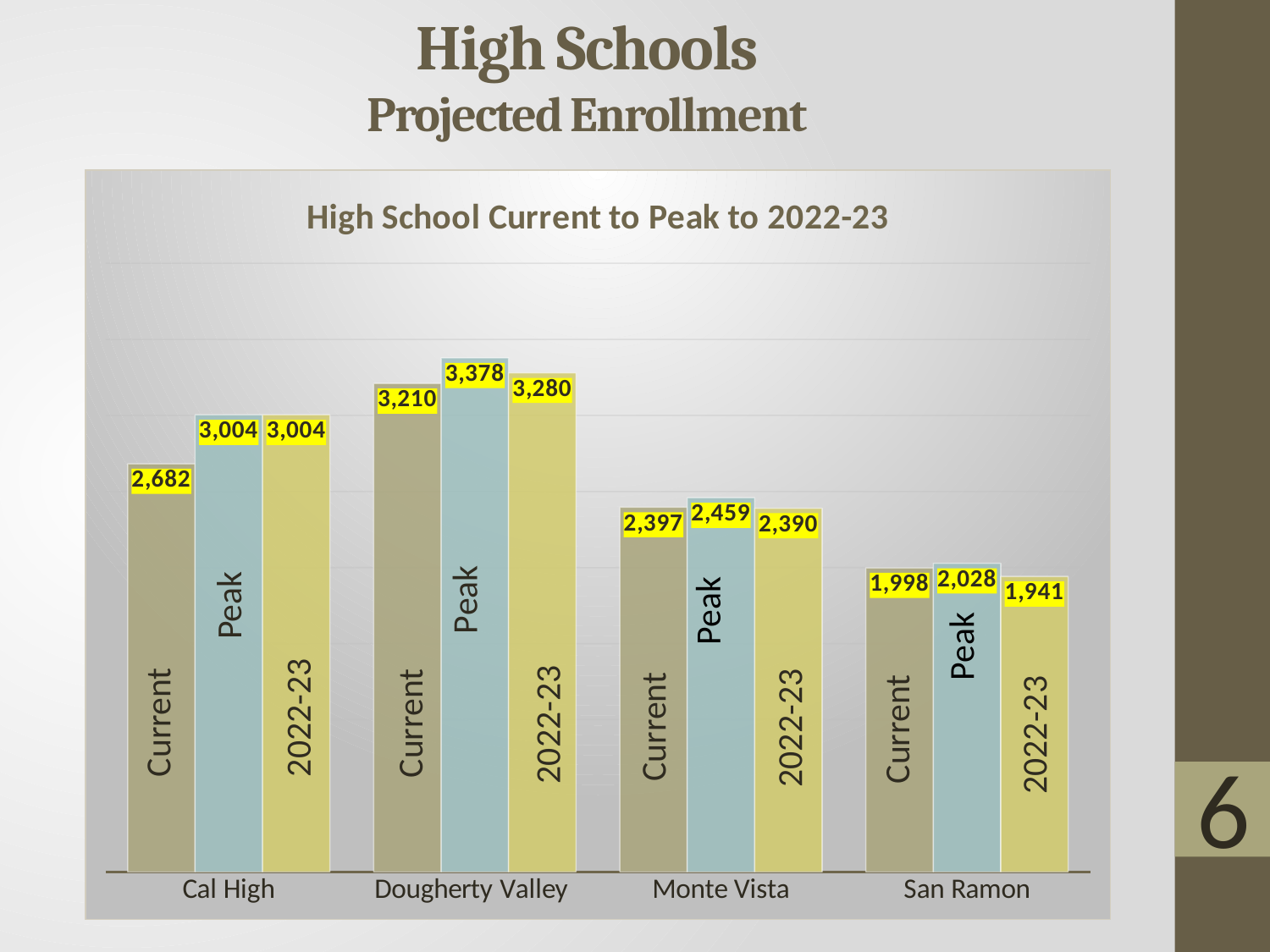
What is the 2022-23 projected enrollment for Monte Vista? 2,390 What is the Current enrollment for Cal High? 2,682 How many schools are shown on the x axis? 4 Which is larger for Monte Vista, the Current enrollment or the 2022-23 enrollment? Current What is the Peak enrollment for Dougherty Valley? 3,378 Which school has the lowest Current enrollment? San Ramon What kind of chart is shown on the slide? Bar chart What is the difference between the Peak and Current enrollment for Cal High? 322 What is the difference between the Peak and 2022-23 enrollment for Dougherty Valley? 98 What is the title of the chart? High School Current to Peak to 2022-23 Which school has the highest Peak enrollment? Dougherty Valley What is the 2022-23 projected enrollment for San Ramon? 1,941